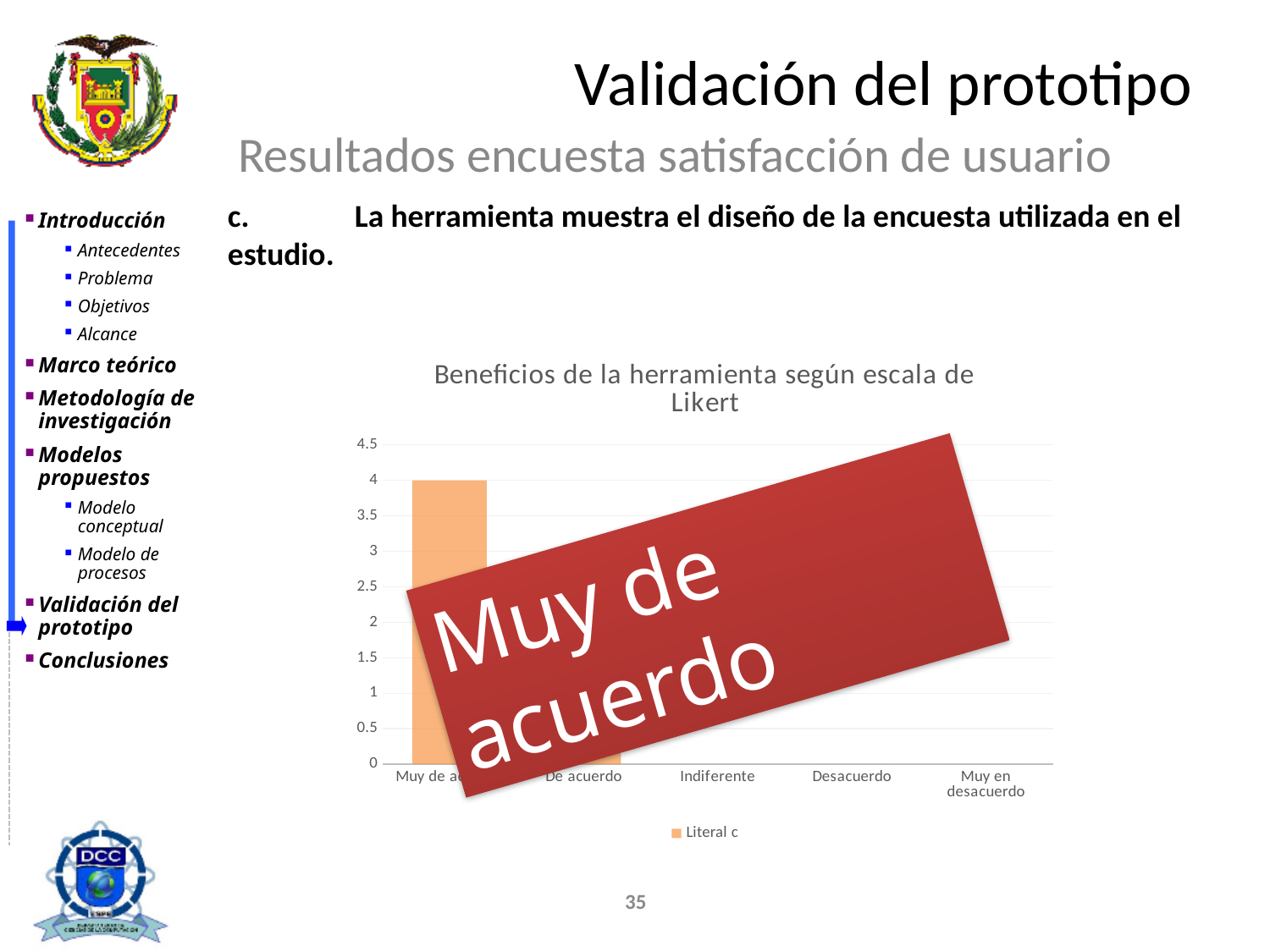
What is the title of the chart? Beneficios de la herramienta según escala de Likert What is the value for "Muy de acuerdo" in the chart? 4 What kind of chart is shown on the slide? bar chart Is the value for "Muy de acuerdo" greater or less than 3? greater How many series does the chart legend list? 1 Which is larger, the value for "Muy de acuerdo" or the value for "Desacuerdo"? Muy de acuerdo What is the highest value shown on the y axis of the chart? 4.5 Which category has the highest value in the chart? Muy de acuerdo How many categories are shown on the x axis of the chart? 5 What is the name of the series listed in the chart legend? Literal c Is the value for "Muy en desacuerdo" greater or less than 1? less